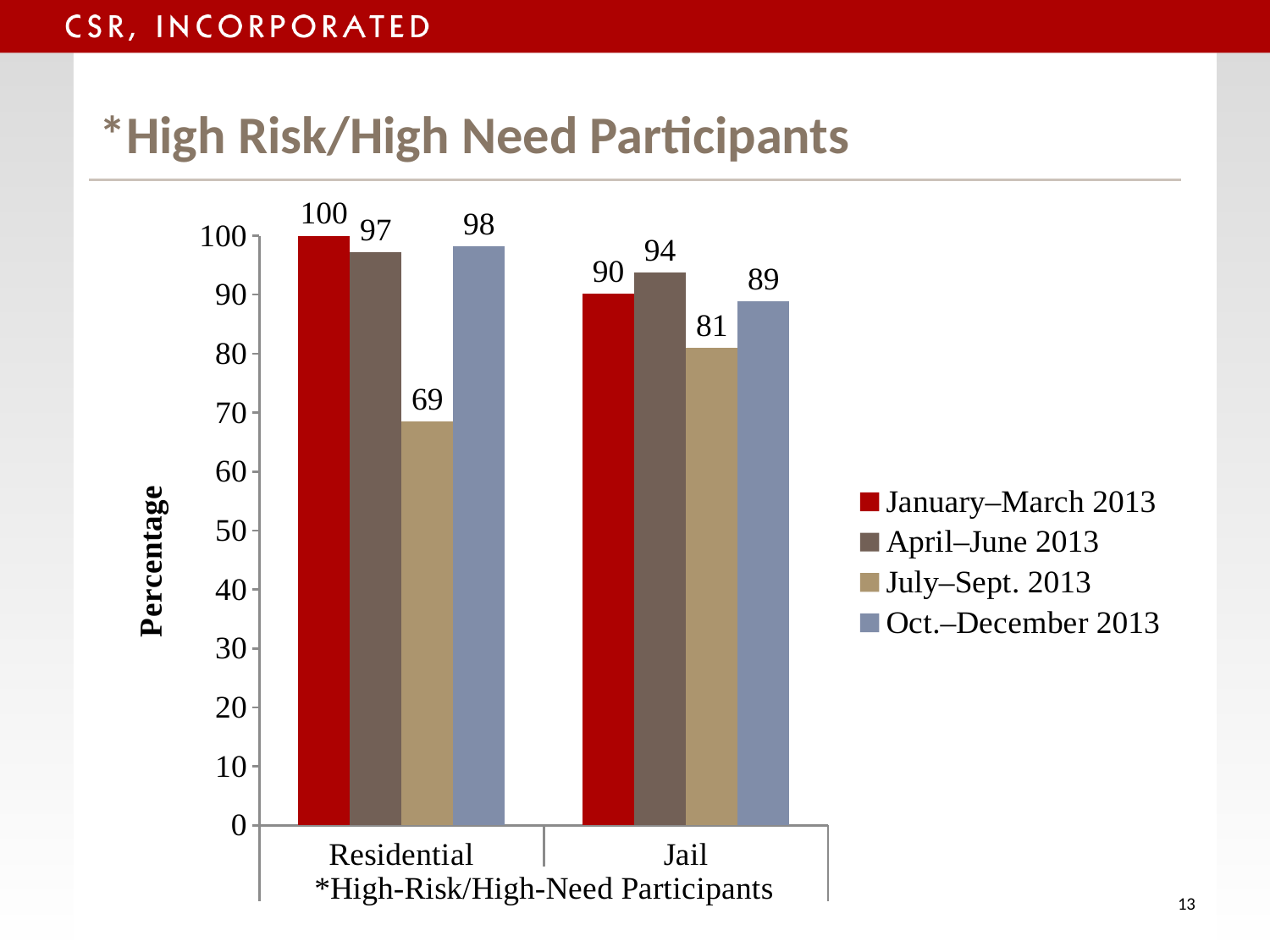
What is the label of the y axis? Percentage What is the value for Residential in January–March 2013? 100 What is the difference between the Residential and Jail values for April–June 2013? 3 What is the difference between the Residential and Jail values for July–Sept. 2013? 12 Which quarter has the lowest value for Residential? July–Sept. 2013 What kind of chart is shown on the slide? Bar chart How many series does the legend list? 4 What is the value for Jail in July–Sept. 2013? 81 Which is larger, the Residential value for Oct.–December 2013 or the Jail value for Oct.–December 2013? Residential Which quarter has the highest value for Jail? April–June 2013 How many categories are shown on the x axis? 2 What is the value for Jail in Oct.–December 2013? 89